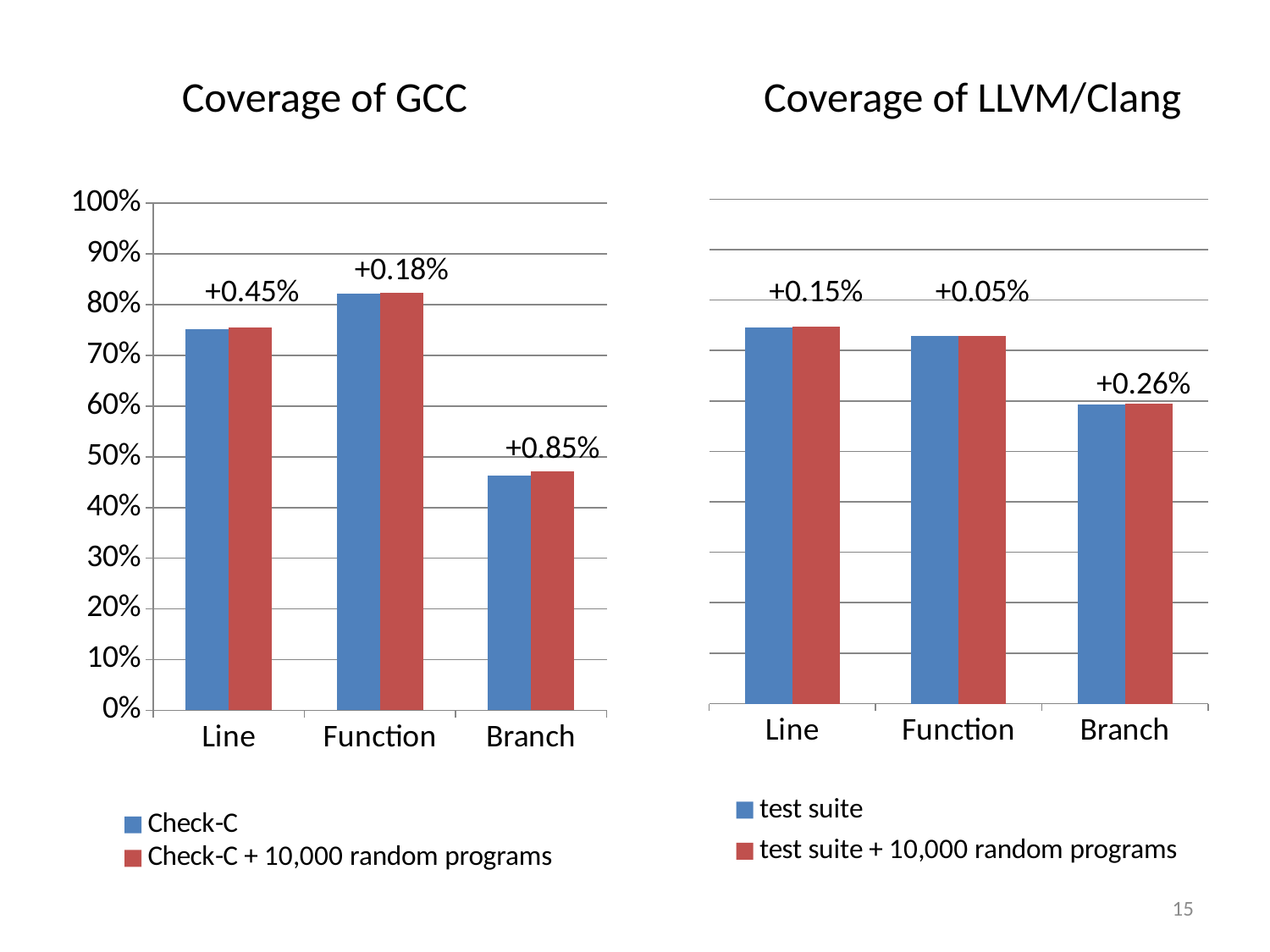
In the Coverage of GCC chart, what increase is labelled above the Line bars? +0.45% In the Coverage of LLVM/Clang chart, what increase is labelled above the Branch bars? +0.26% In the Coverage of GCC chart, which category has the lowest coverage? Branch What kind of chart is the Coverage of GCC chart? bar chart In the Coverage of LLVM/Clang chart, which category has the highest coverage? Line In the Coverage of GCC chart, is the Check-C value for Line greater or less than 70%? greater In the Coverage of GCC chart, which category has the highest coverage? Function In the Coverage of GCC chart, is the Check-C value for Branch greater or less than 50%? less How many series does the legend of the Coverage of LLVM/Clang chart list? 2 In the Coverage of GCC chart, which is larger, the coverage for Line or for Branch? Line In the Coverage of GCC chart, is the Check-C value for Function greater or less than 80%? greater In the Coverage of LLVM/Clang chart, which category has the lowest coverage? Branch